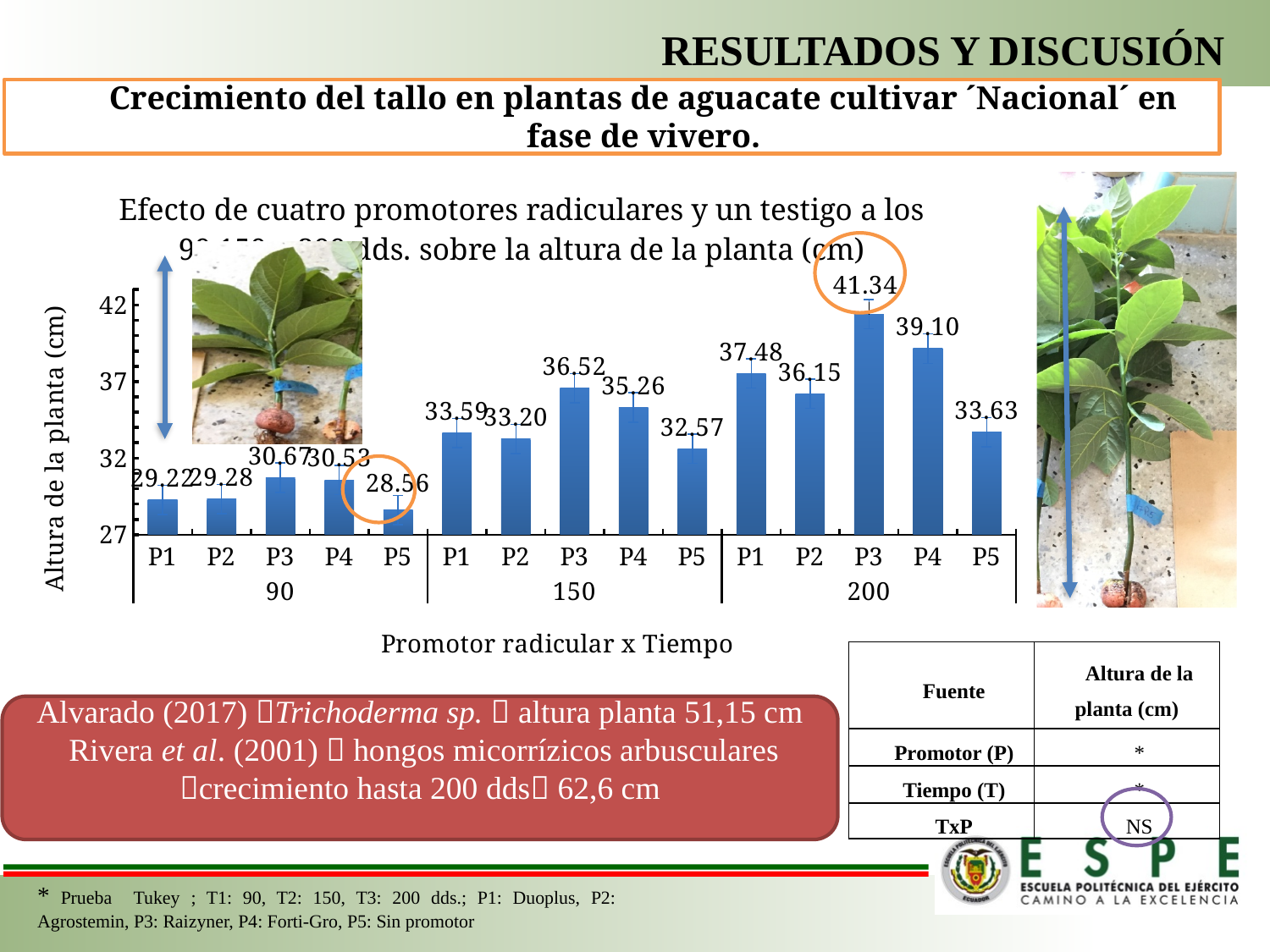
Which is larger, the value for P4 at 200 dds or the value for P2 at 200 dds? P4 at 200 dds What is the plant height value for P1 at 150 dds? 33.59 Which bar has the highest value in the chart? P3 at 200 What is the difference between the values for P3 at 200 dds and P5 at 90 dds? 12.78 What is the label of the vertical axis of the chart? Altura de la planta (cm) What is the plant height value for P3 at 200 dds? 41.34 Do the values for P3 rise or fall from 90 to 200 dds? Rise Which bar has the lowest value in the chart? P5 at 90 What kind of chart is shown on the slide? Bar chart How many bars are plotted in the chart? 15 What is the plant height value for P5 at 90 dds? 28.56 Is the value for P3 at 150 dds greater or less than 32? greater